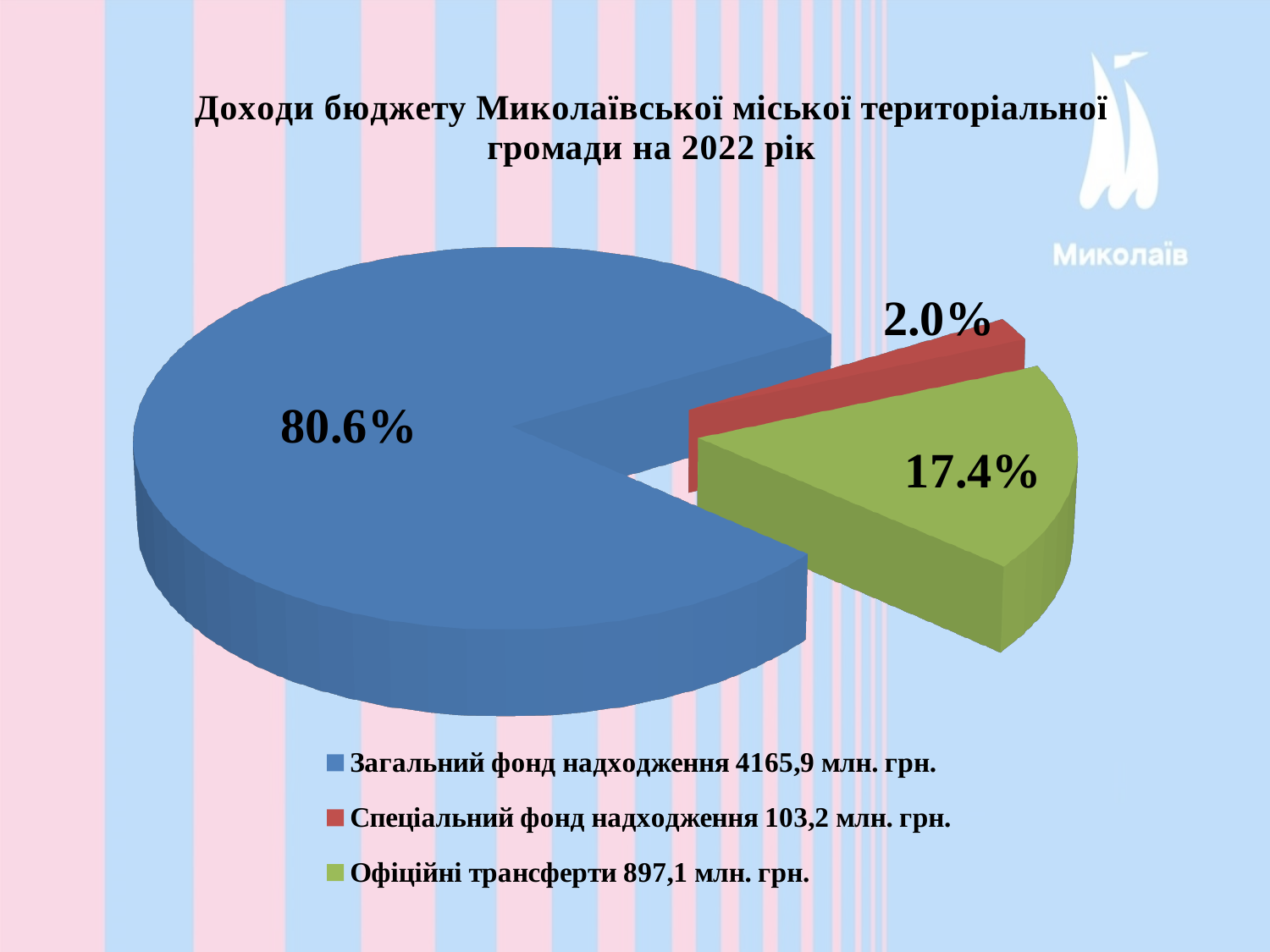
What share of the pie does "Загальний фонд надходження" represent? 80.6% How many entries does the legend list? 3 Which category has the largest slice of the pie? Загальний фонд надходження What type of chart is shown on the slide? Pie chart Which is larger: the "Офіційні трансферти" slice or the "Спеціальний фонд надходження" slice? Офіційні трансферти What share of the pie does "Спеціальний фонд надходження" represent? 2.0% What share of the pie does "Офіційні трансферти" represent? 17.4% What colour is the slice for "Спеціальний фонд надходження"? Red Which category has the smallest slice of the pie? Спеціальний фонд надходження How many slices does the pie chart have? 3 What is the difference in percentage points between the "Загальний фонд надходження" slice and the "Офіційні трансферти" slice? 63.2 percentage points According to the legend, what amount in млн. грн. is given for "Офіційні трансферти"? 897,1 млн. грн.